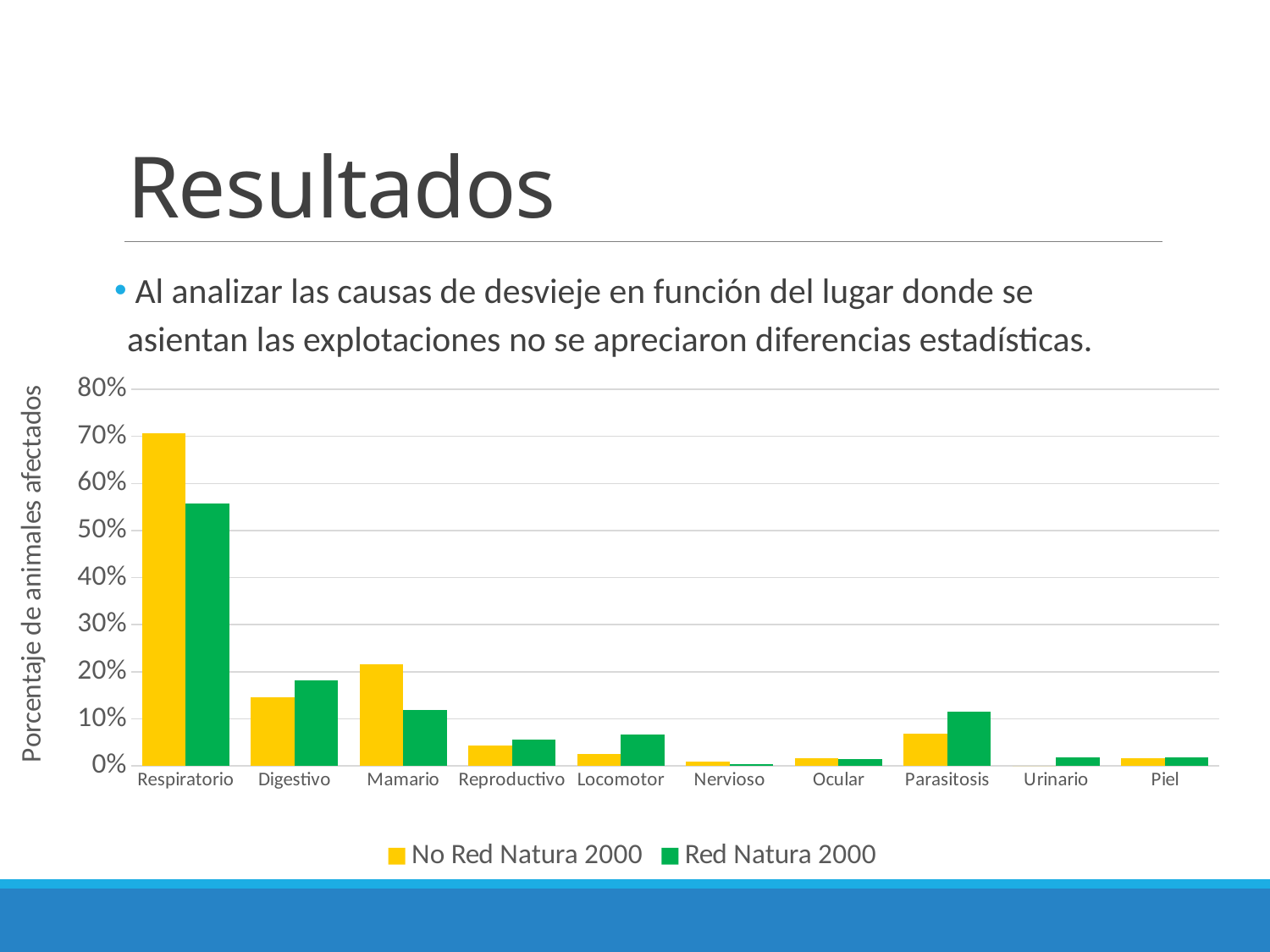
How many series does the chart legend list? 2 What is the title of the vertical axis of the chart? Porcentaje de animales afectados What kind of chart is shown on the slide? bar chart Which category has the highest value for the No Red Natura 2000 series? Respiratorio For Respiratorio, which series has the larger value, No Red Natura 2000 or Red Natura 2000? No Red Natura 2000 For Parasitosis, which series has the larger value, No Red Natura 2000 or Red Natura 2000? Red Natura 2000 Which category has the highest value for the Red Natura 2000 series? Respiratorio For Digestivo, which series has the larger value, No Red Natura 2000 or Red Natura 2000? Red Natura 2000 Is the value for Respiratorio in the No Red Natura 2000 series greater or less than 60%? greater Is the value for Respiratorio in the Red Natura 2000 series greater or less than 50%? greater How many categories are shown on the x axis of the chart? 10